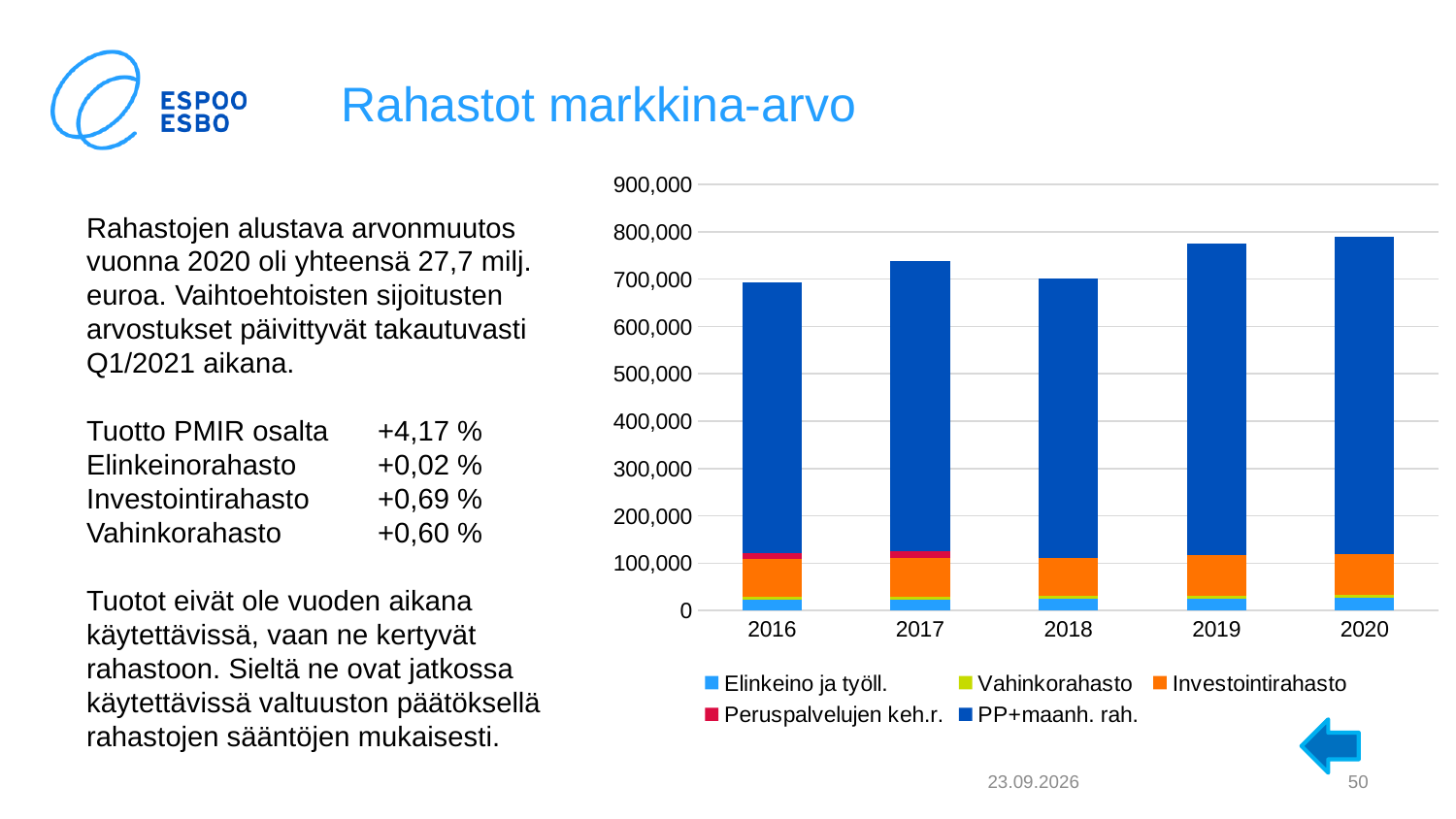
Which series makes up the largest part of each stacked bar? PP+maanh. rah. Which year has the highest total bar in the chart? 2020 Which year has the larger total bar, 2018 or 2019? 2019 Which year has the larger total bar, 2016 or 2017? 2017 How many years are shown on the x axis of the chart? 5 Is the total bar for 2018 greater or less than 800,000? less What is the title of the chart? Rahastot markkina-arvo Is the total bar for 2019 greater or less than 700,000? greater How many series does the chart legend list? 5 Is the total bar for 2017 greater or less than 700,000? greater Overall, do the total bar heights rise or fall from 2016 to 2020? rise What kind of chart is shown on the slide? Stacked bar chart